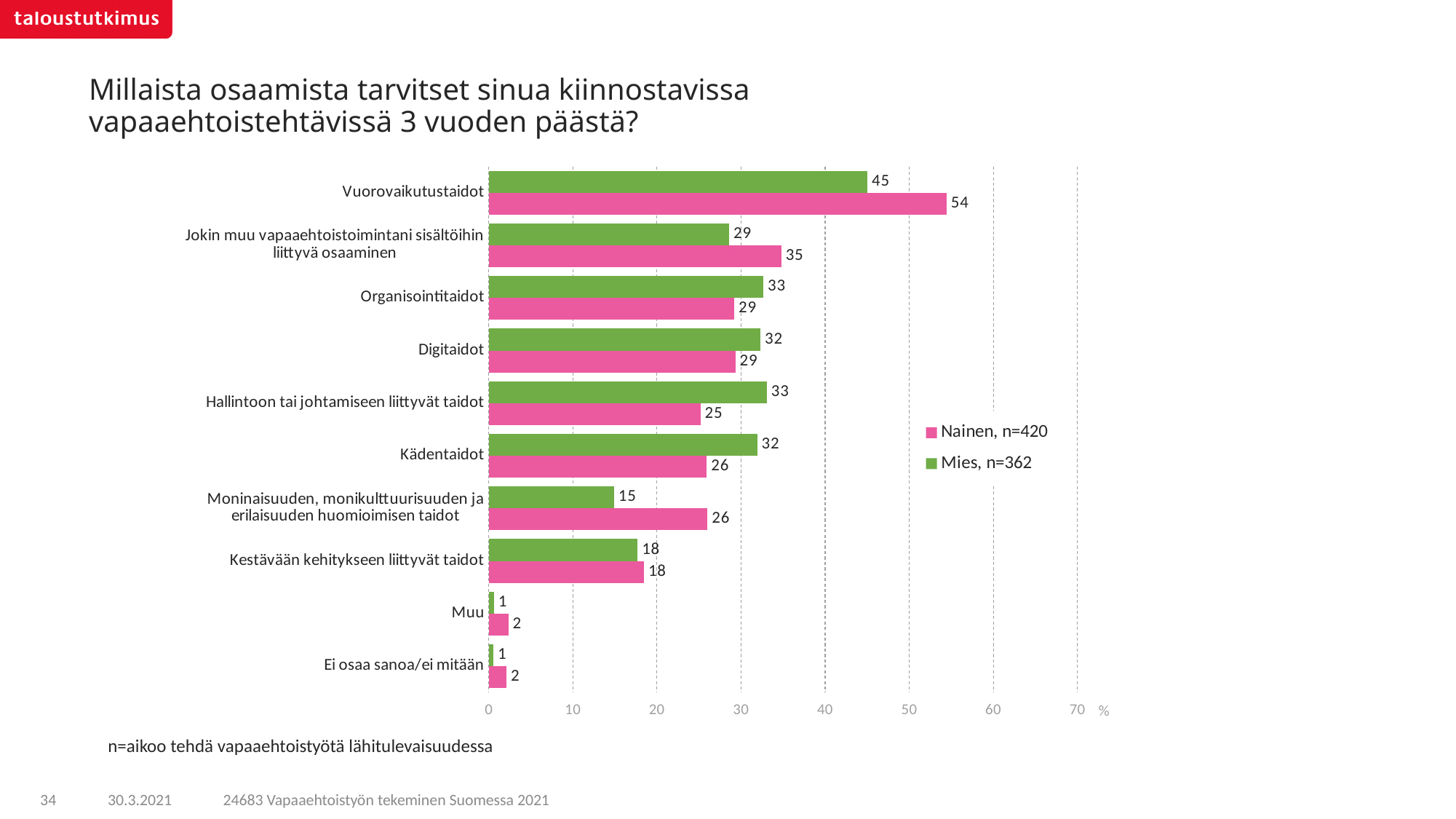
What is the value for Mies, n=362 for Kädentaidot? 32 Which category has the lowest value for Nainen, n=420? Muu and Ei osaa sanoa/ei mitään (both 2) Which is larger for Digitaidot: the Nainen, n=420 value or the Mies, n=362 value? Mies, n=362 What is the value for Nainen, n=420 for Hallintoon tai johtamiseen liittyvät taidot? 25 How many categories are shown on the chart? 10 How many series does the legend list? 2 Which category has the highest value for Mies, n=362? Vuorovaikutustaidot Which colour represents the Nainen, n=420 series? pink Is the value for Nainen, n=420 for Vuorovaikutustaidot greater or less than 50? greater What is the difference between the Nainen, n=420 and Mies, n=362 values for Moninaisuuden, monikulttuurisuuden ja erilaisuuden huomioimisen taidot? 11 What kind of chart is shown on the slide? bar chart What is the value for Nainen, n=420 for Vuorovaikutustaidot? 54